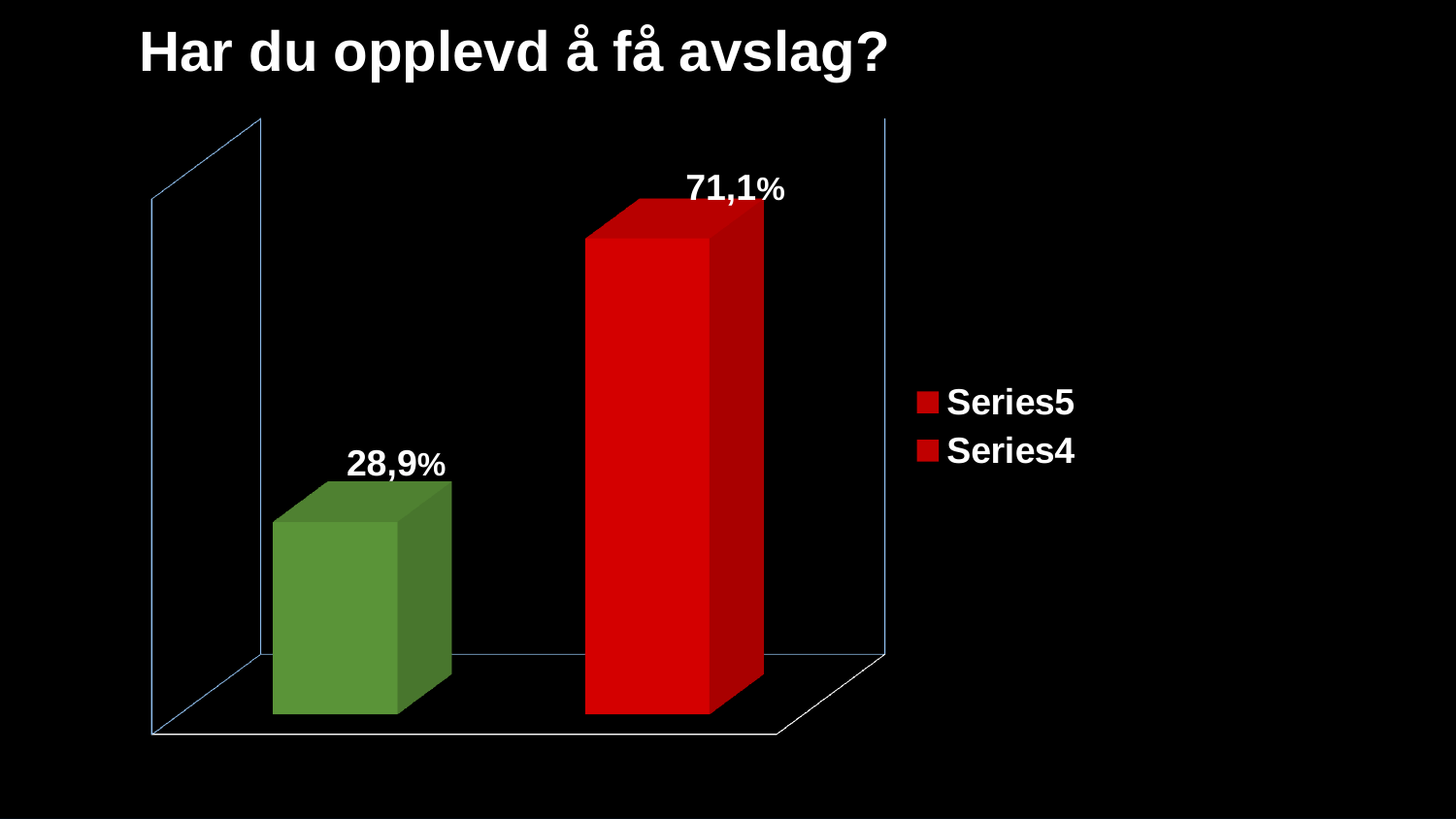
What are the two entries listed in the legend? Series5 and Series4 What is the title of the slide? Har du opplevd å få avslag? How many series does the legend list? 2 Which bar has the highest value, the green one or the red one? the red bar Which bar has the lowest value, the green one or the red one? the green bar Is the value of the green bar larger or smaller than the value of the red bar? smaller How many bars are plotted in the chart? 2 What kind of chart is shown on the slide? bar chart What value is shown on the green bar? 28,9% What is the difference between the red bar's value and the green bar's value? 42,2% What value is shown on the red bar? 71,1%